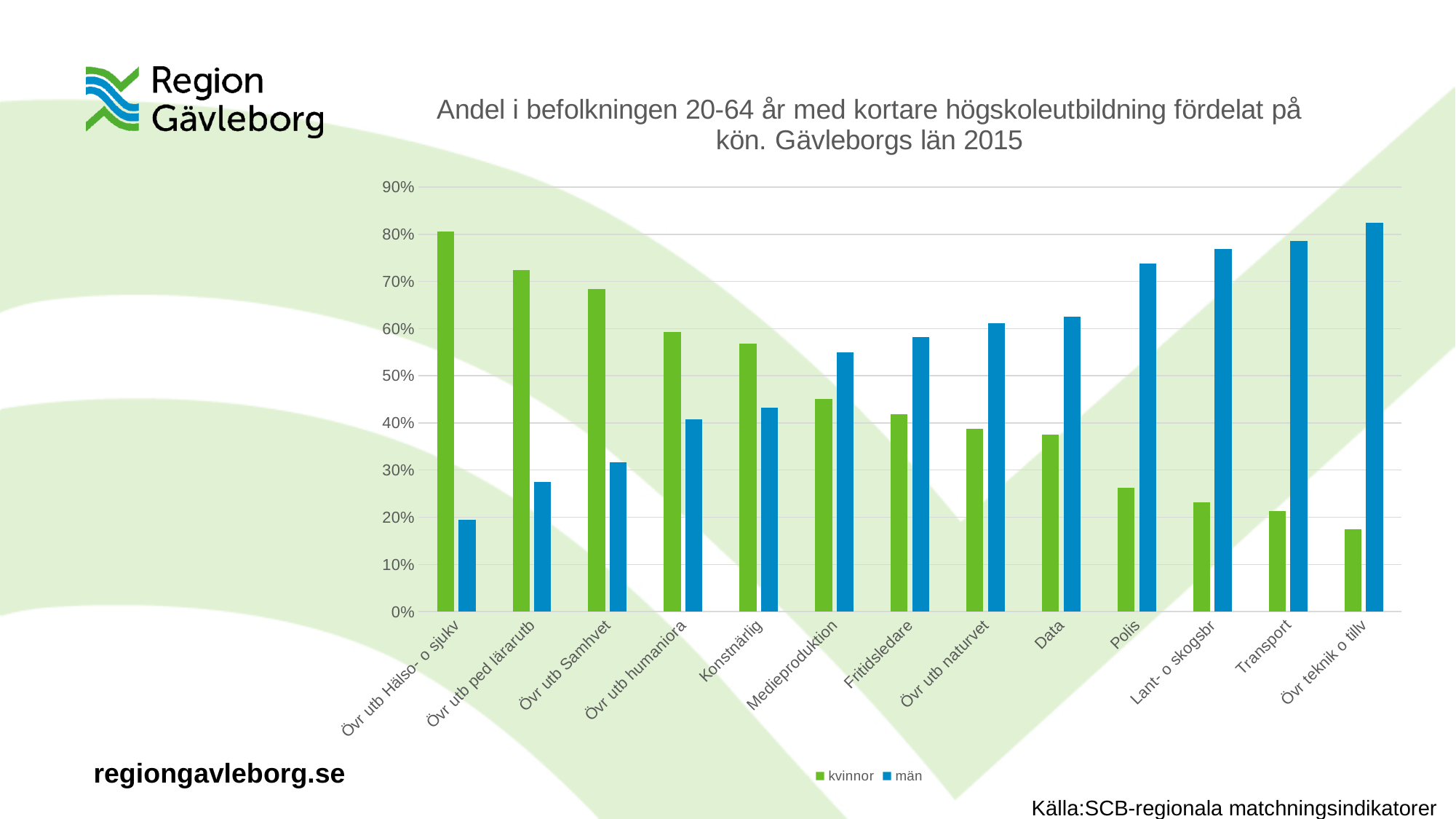
How many series does the legend list? 2 Is the value for män in Polis greater or less than 70%? greater For Konstnärlig, which series has the larger value, kvinnor or män? kvinnor Which category has the highest value for män? Övr teknik o tillv What kind of chart is shown on the slide? bar chart Which category has the lowest value for män? Övr utb Hälso- o sjukv Which colour represents the män series in the chart? blue How many categories are shown on the x axis? 13 Do the values for kvinnor rise or fall from left to right along the x axis? fall Which category has the highest value for kvinnor? Övr utb Hälso- o sjukv Which category has the lowest value for kvinnor? Övr teknik o tillv Is the value for kvinnor in Data greater or less than 40%? less